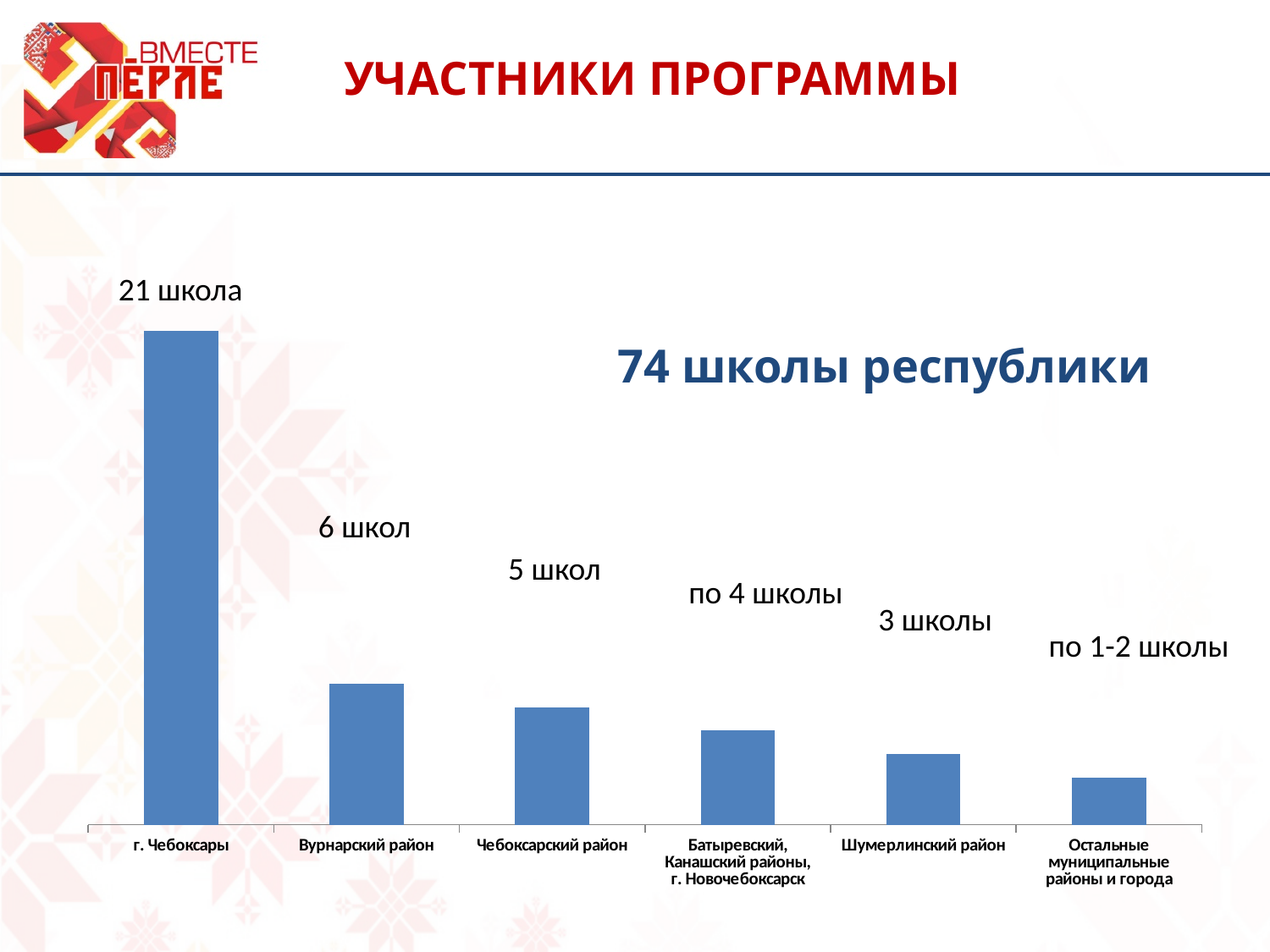
By how many schools does г. Чебоксары exceed Вурнарский район? 15 How many schools does the bar for г. Чебоксары show? 21 школа What is the value labelled for Вурнарский район? 6 школ How many categories are shown on the x axis of the chart? 6 What is the value labelled for Чебоксарский район? 5 школ What label is shown above the bar for Батыревский, Канашский районы, г. Новочебоксарск? по 4 школы Which category has the highest bar? г. Чебоксары What label is shown above the bar for Остальные муниципальные районы и города? по 1-2 школы Which has more schools, Вурнарский район or Чебоксарский район? Вурнарский район What is the value labelled for Шумерлинский район? 3 школы Which category has the lowest bar? Остальные муниципальные районы и города What kind of chart is shown on the slide? bar chart